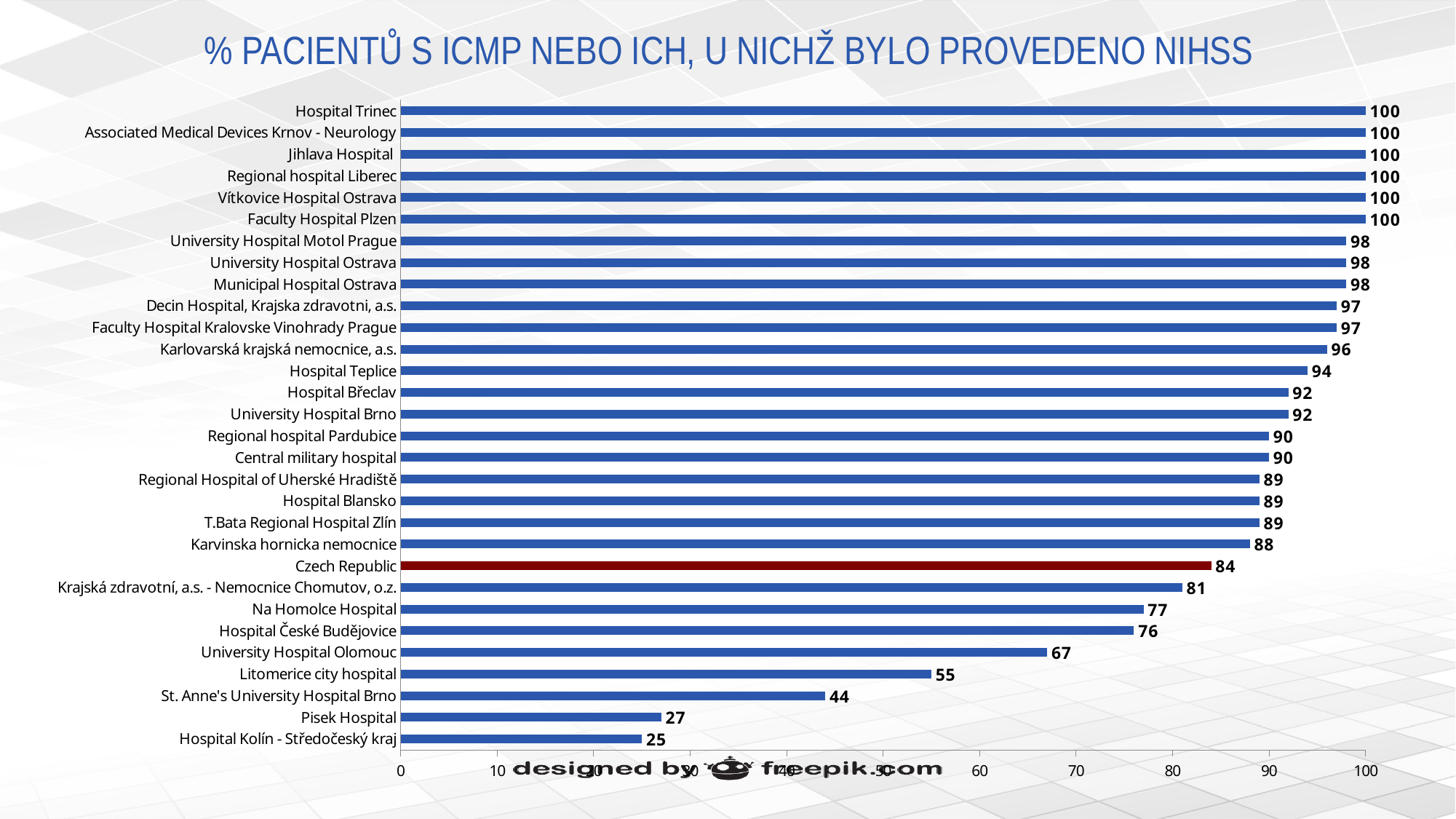
What kind of chart is shown on the slide? bar chart What is the value for University Hospital Olomouc? 67 Which category's bar is coloured dark red instead of blue? Czech Republic What is the difference between the values for Hospital Teplice and Litomerice city hospital? 39 Is the value for Karvinska hornicka nemocnice greater or less than 80? greater What is the value for St. Anne's University Hospital Brno? 44 What is the value for Czech Republic? 84 What is the title of the chart? % PACIENTŮ S ICMP NEBO ICH, U NICHŽ BYLO PROVEDENO NIHSS What is the difference between the values for Czech Republic and Pisek Hospital? 57 Which is larger, the value for Na Homolce Hospital or the value for Hospital České Budějovice? Na Homolce Hospital How many categories are shown in the chart? 30 Which category has the lowest value? Hospital Kolín - Středočeský kraj